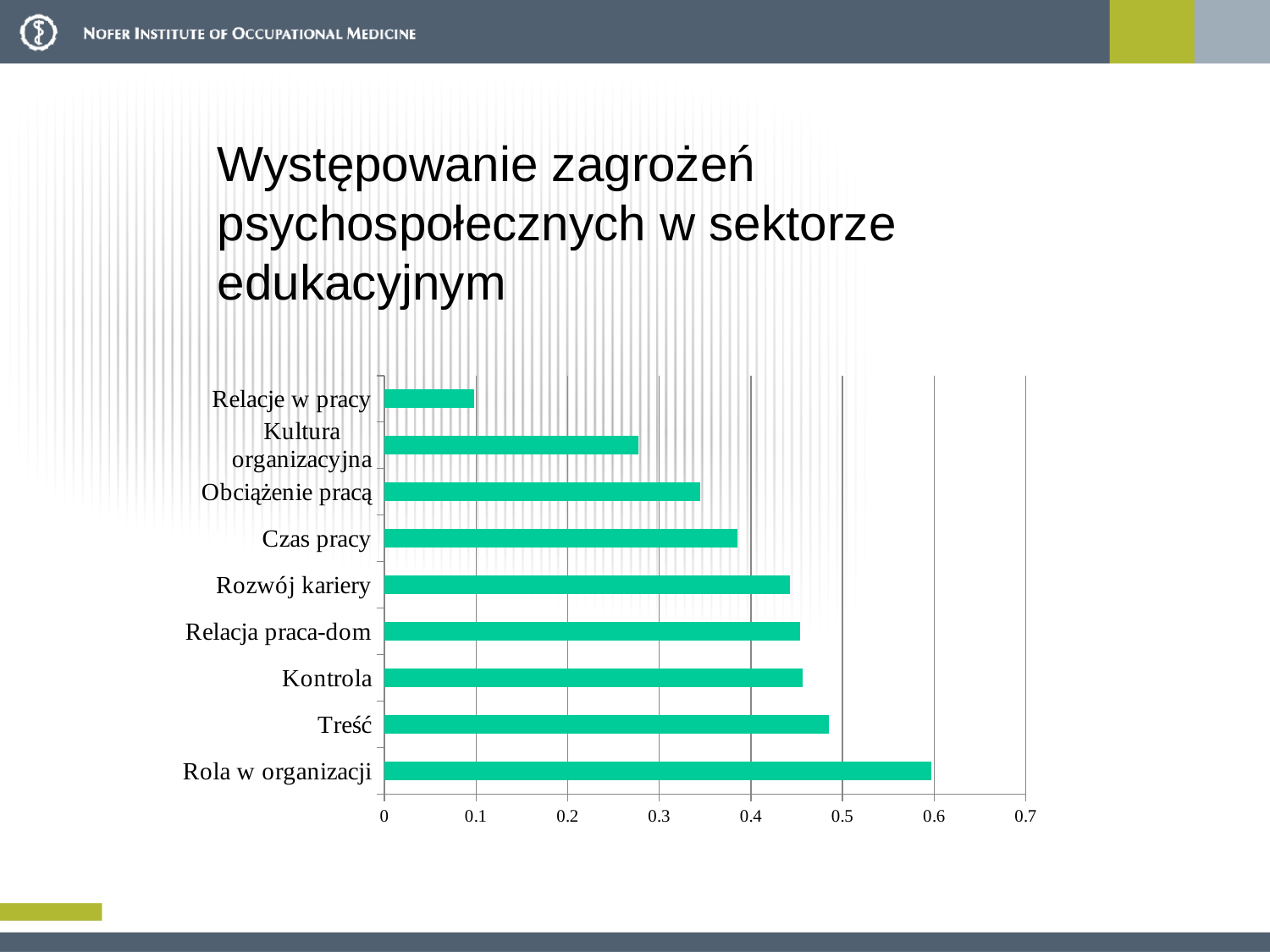
Is the value for Kultura organizacyjna greater or less than 0.3? less Which has a larger value, Obciążenie pracą or Rozwój kariery? Rozwój kariery How many categories are shown in the chart? 9 Is the value for Rola w organizacji greater or less than 0.5? greater Which category has the lowest value? Relacje w pracy Which has a larger value, Treść or Czas pracy? Treść What type of chart is shown on the slide? bar chart Which category has the highest value? Rola w organizacji What is the maximum value shown on the horizontal axis? 0.7 Is the value for Treść greater or less than 0.5? less